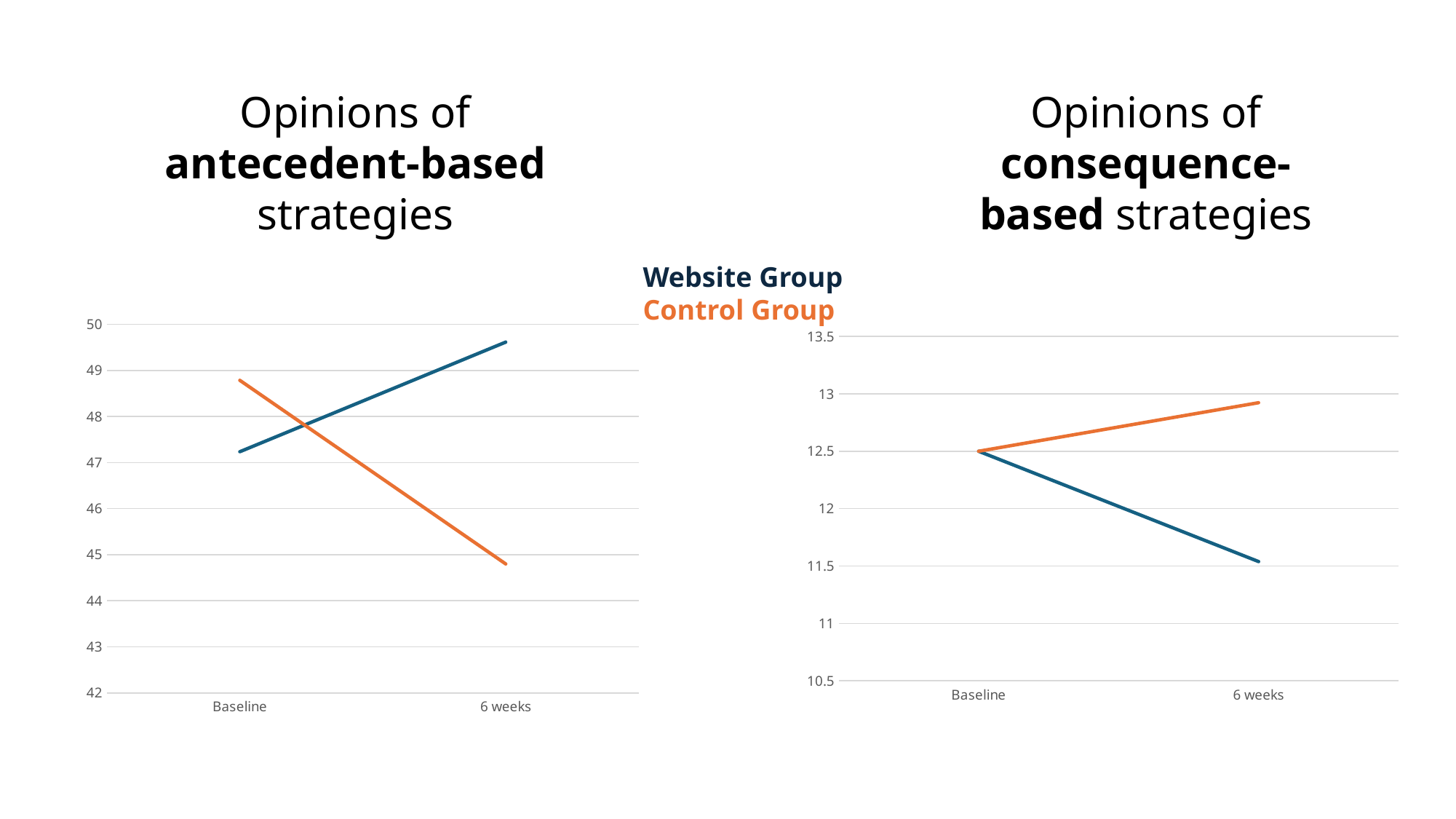
In the 'Opinions of consequence-based strategies' chart, is the Website Group value at 6 weeks greater or less than 12? less What kind of chart is the 'Opinions of antecedent-based strategies' chart? line chart In the 'Opinions of antecedent-based strategies' chart, does the Website Group line rise or fall from Baseline to 6 weeks? rise In the 'Opinions of consequence-based strategies' chart, does the Control Group line rise or fall from Baseline to 6 weeks? rise In the 'Opinions of antecedent-based strategies' chart, does the Control Group line rise or fall from Baseline to 6 weeks? fall How many time points are shown on the x axis of the 'Opinions of consequence-based strategies' chart? 2 In the 'Opinions of antecedent-based strategies' chart, is the Website Group value at 6 weeks greater or less than 49? greater In the 'Opinions of antecedent-based strategies' chart, is the Control Group value at 6 weeks greater or less than 46? less How many series does the legend list for the charts? 2 In the 'Opinions of antecedent-based strategies' chart, which group has the higher value at Baseline? Control Group In the 'Opinions of consequence-based strategies' chart, which group has the higher value at 6 weeks? Control Group